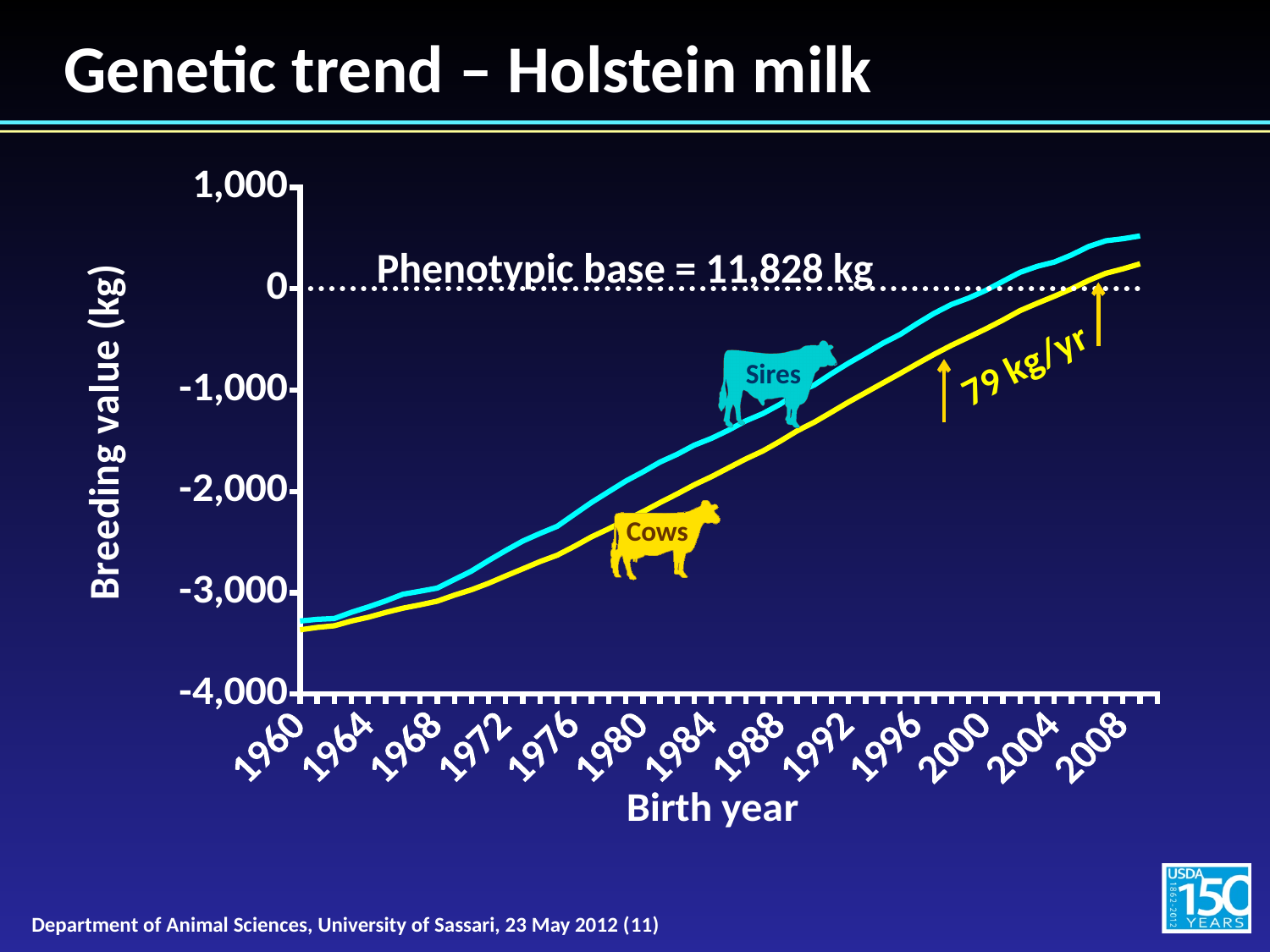
How many data series are plotted on the chart? 2 Is the breeding value for Sires in 2008 greater or less than 0? greater Which series reaches the highest breeding value on the chart? Sires Which series has the higher breeding value for birth year 2000, Sires or Cows? Sires Is the breeding value for Cows in 1980 greater or less than -2,000? less Do the breeding values rise or fall as birth year increases? rise What annual rate of genetic gain is annotated on the chart? 79 kg/yr What kind of chart is shown on the slide? line chart Is the breeding value for Cows in 1996 greater or less than -1,000? greater How many birth-year labels are shown on the x axis? 13 What phenotypic base value is stated on the chart? 11,828 kg